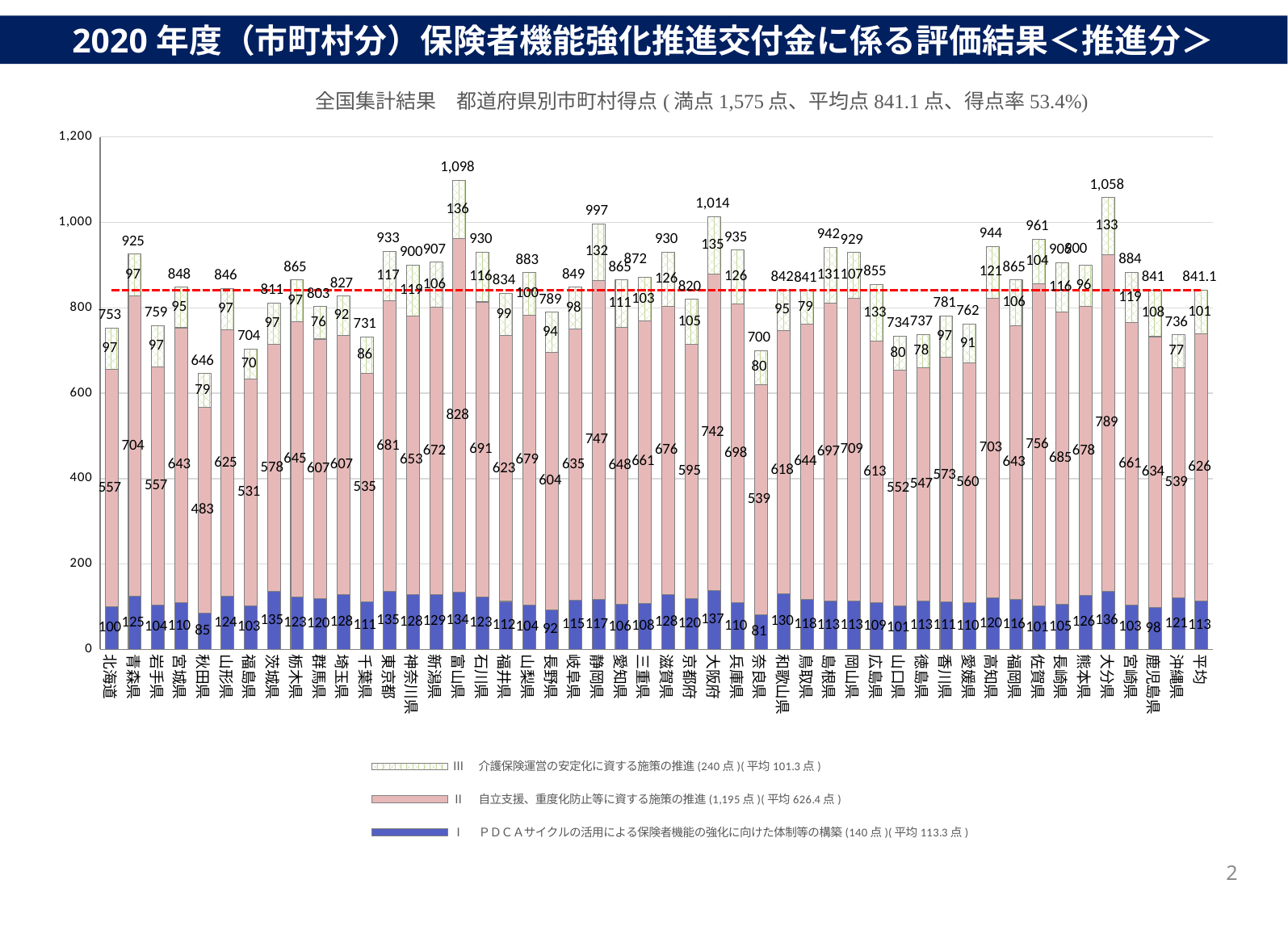
What kind of chart is shown on the slide? stacked bar chart Which prefecture has the lowest total score? 秋田県 Is the total score for 奈良県 greater or less than 800? less What value does the red dashed horizontal line represent? 841.1 Which prefecture has the highest total score? 富山県 What is the value of the middle (II) segment for 東京都? 681 What is the difference between the total scores of 大分県 and 大阪府? 44 How many series does the legend list? 3 What is the value of the bottom (I) segment for 秋田県? 85 What is the total score shown for 富山県? 1,098 Which has a higher total score, 静岡県 or 佐賀県? 静岡県 What is the total score shown for the 平均 bar? 841.1